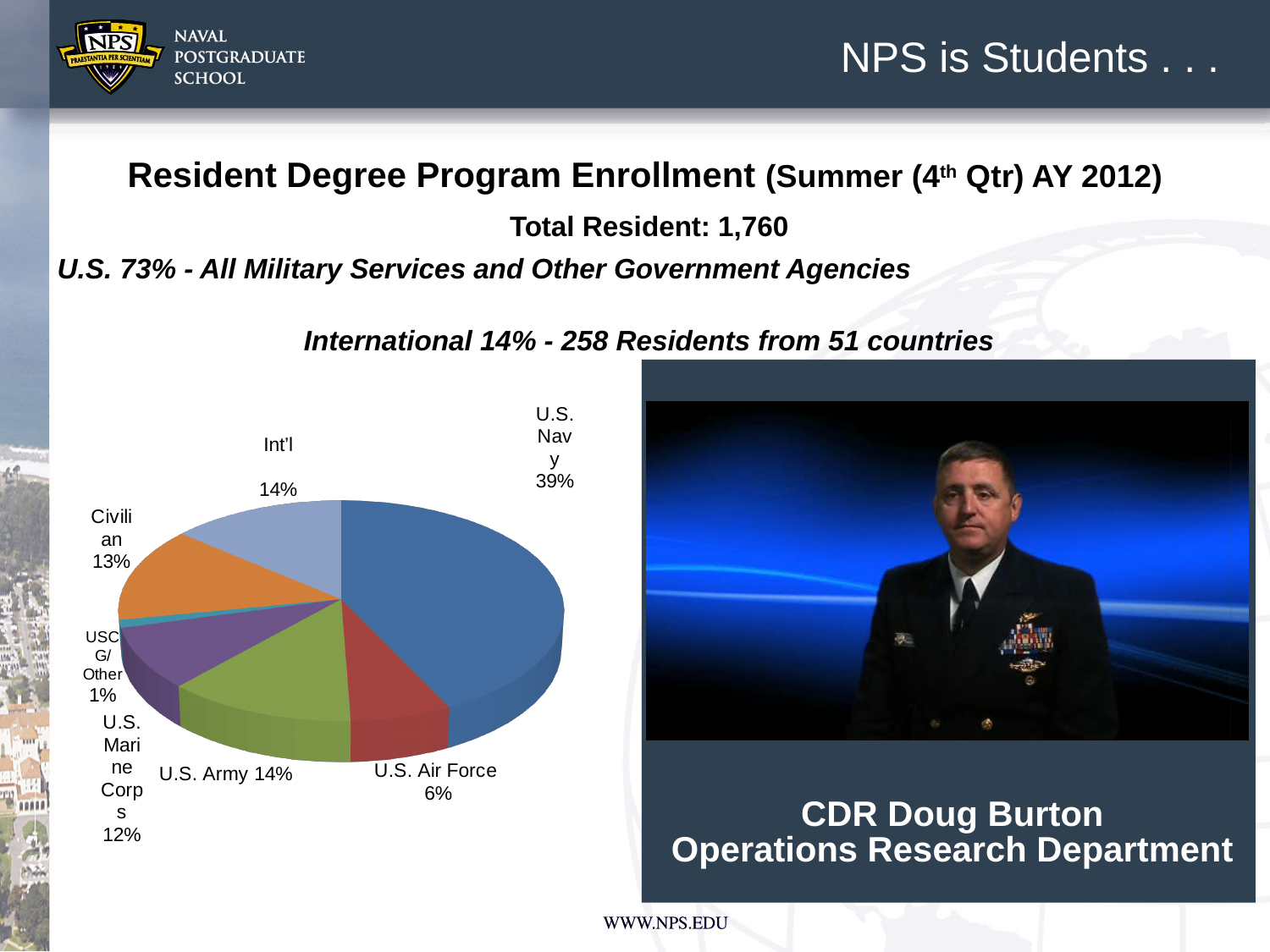
What is the value shown for Int'l? 14% What is the value shown for U.S. Air Force? 6% What is the value shown for U.S. Marine Corps? 12% Which is larger, the Civilian share or the U.S. Air Force share? Civilian Which category has the largest slice of the pie? U.S. Navy What is the value shown for U.S. Army? 14% Which category has the smallest slice of the pie? USCG/Other How many slices does the pie chart have? 7 What kind of chart is shown on the slide? pie chart What is the difference between the U.S. Navy share and the U.S. Army share? 25% What share of the pie does U.S. Navy hold? 39% What is the value shown for Civilian? 13%